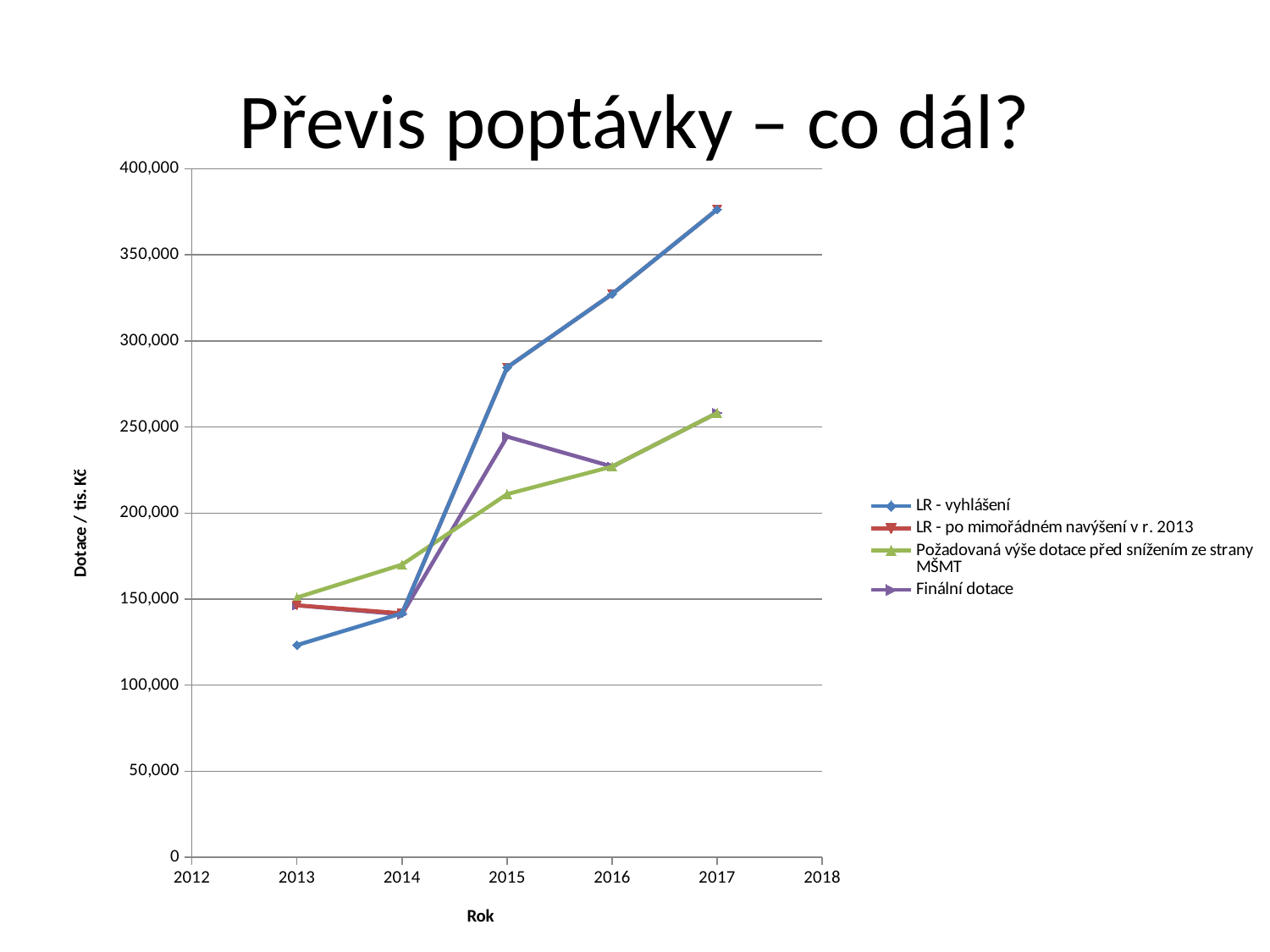
In which year is the 'LR - vyhlášení' series at its highest? 2017 How many years have data points plotted for the 'LR - vyhlášení' series? 5 How many series does the legend list? 4 Is the value for 'LR - vyhlášení' in 2017 greater or less than 350,000? greater Does the 'LR - vyhlášení' series rise or fall from 2013 to 2017? rise What kind of chart is shown on the slide? line chart Is the value for 'LR - vyhlášení' in 2015 greater or less than 300,000? less Does the 'Finální dotace' series rise or fall between 2015 and 2016? fall Is the value for 'LR - vyhlášení' in 2013 greater or less than 150,000? less In 2017, which is larger: 'LR - vyhlášení' or 'Požadovaná výše dotace před snížením ze strany MŠMT'? LR - vyhlášení What is the label of the vertical axis? Dotace / tis. Kč